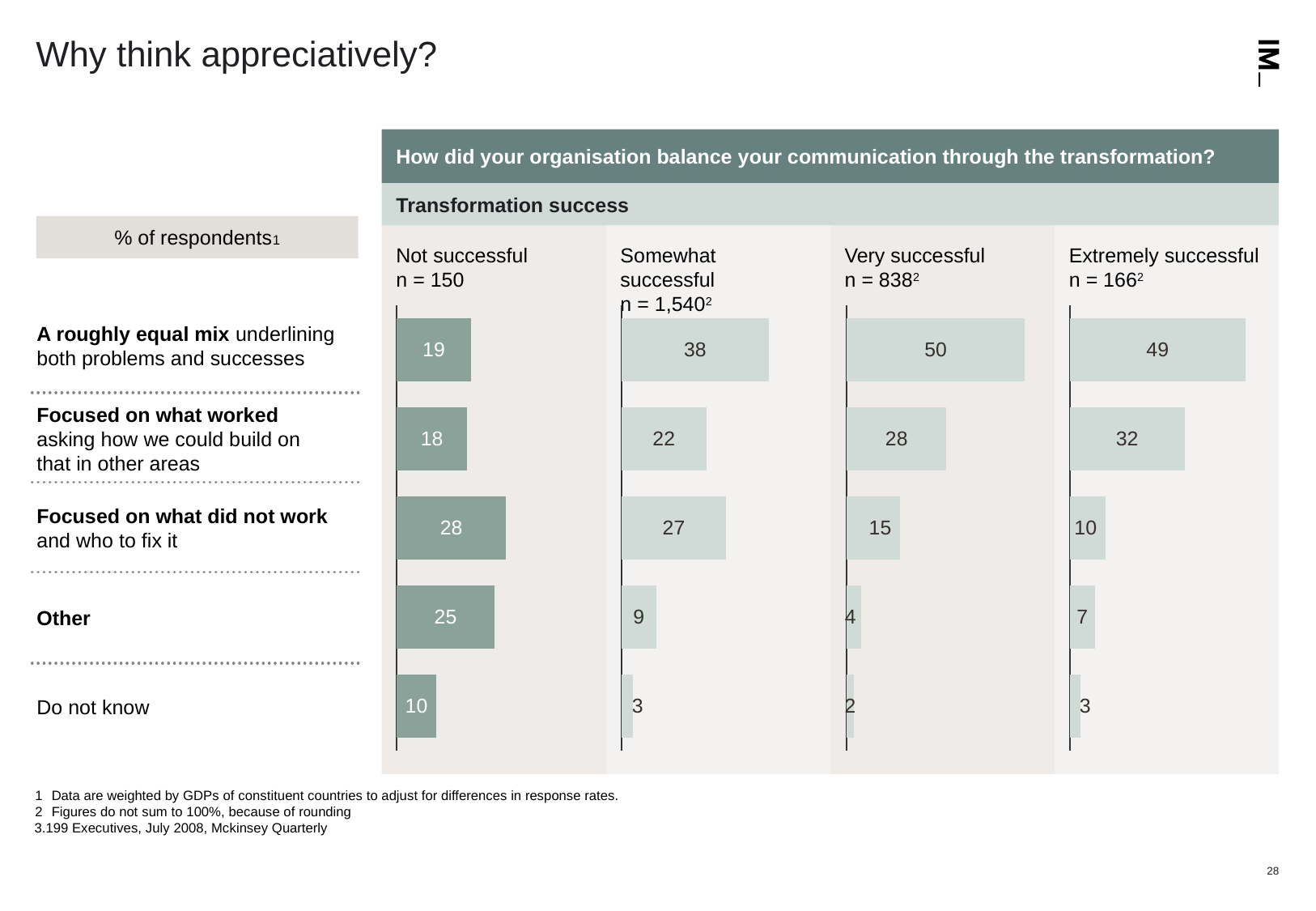
In the 'Extremely successful' chart, what is the difference between 'A roughly equal mix' and 'Focused on what worked'? 17 What kind of chart is used in the 'Not successful' panel? Bar chart In the 'Not successful' chart, which category has the highest value? Focused on what did not work How many categories are shown in each of the bar charts? 5 In the 'Somewhat successful' chart, what is the value for 'Do not know'? 3 In the 'Not successful' chart, what is the difference between 'Other' and 'Do not know'? 15 In the 'Extremely successful' chart, what is the value for 'Focused on what worked'? 32 In the 'Very successful' chart, what is the value for 'A roughly equal mix'? 50 In the 'Somewhat successful' chart, which is larger: 'Focused on what worked' or 'Focused on what did not work'? Focused on what did not work In the 'Very successful' chart, which category has the lowest value? Do not know In the 'Not successful' chart, what is the value for 'Focused on what did not work'? 28 What is the sample size (n) shown for the 'Somewhat successful' chart? 1,540